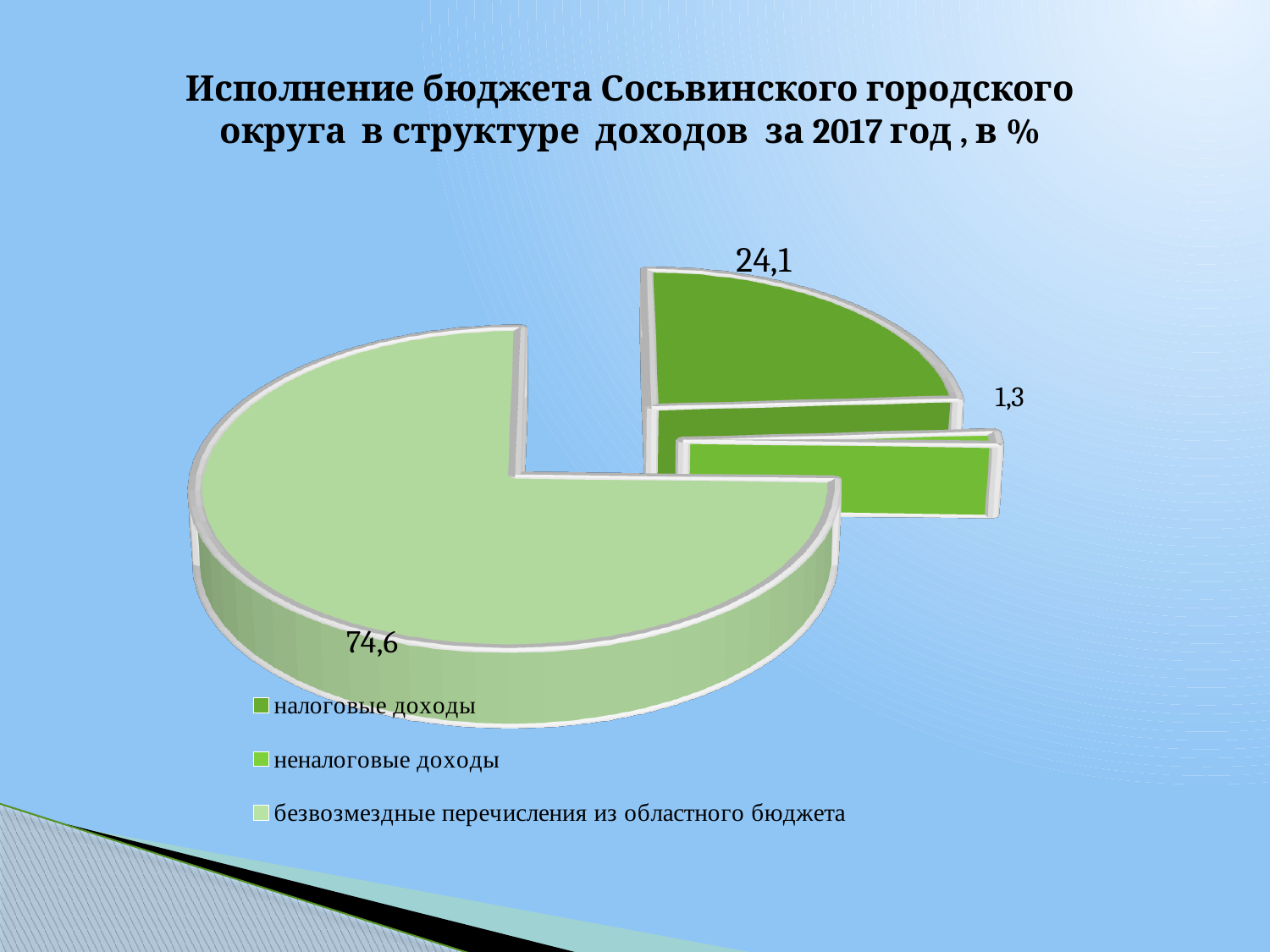
What is the value for налоговые доходы? 24,1 What is the value for неналоговые доходы? 1,3 Which is larger: налоговые доходы or неналоговые доходы? налоговые доходы Which category has the largest slice of the pie? безвозмездные перечисления из областного бюджета Which category has the smallest slice of the pie? неналоговые доходы What is the difference between the values for безвозмездные перечисления из областного бюджета and налоговые доходы? 50,5 How many categories does the pie chart have? 3 What is the title of the chart? Исполнение бюджета Сосьвинского городского округа в структуре доходов за 2017 год, в % What is the difference between the values for налоговые доходы and неналоговые доходы? 22,8 What is the value for безвозмездные перечисления из областного бюджета? 74,6 What share of the pie does налоговые доходы represent, in percent? 24,1 What kind of chart is shown on the slide? Pie chart